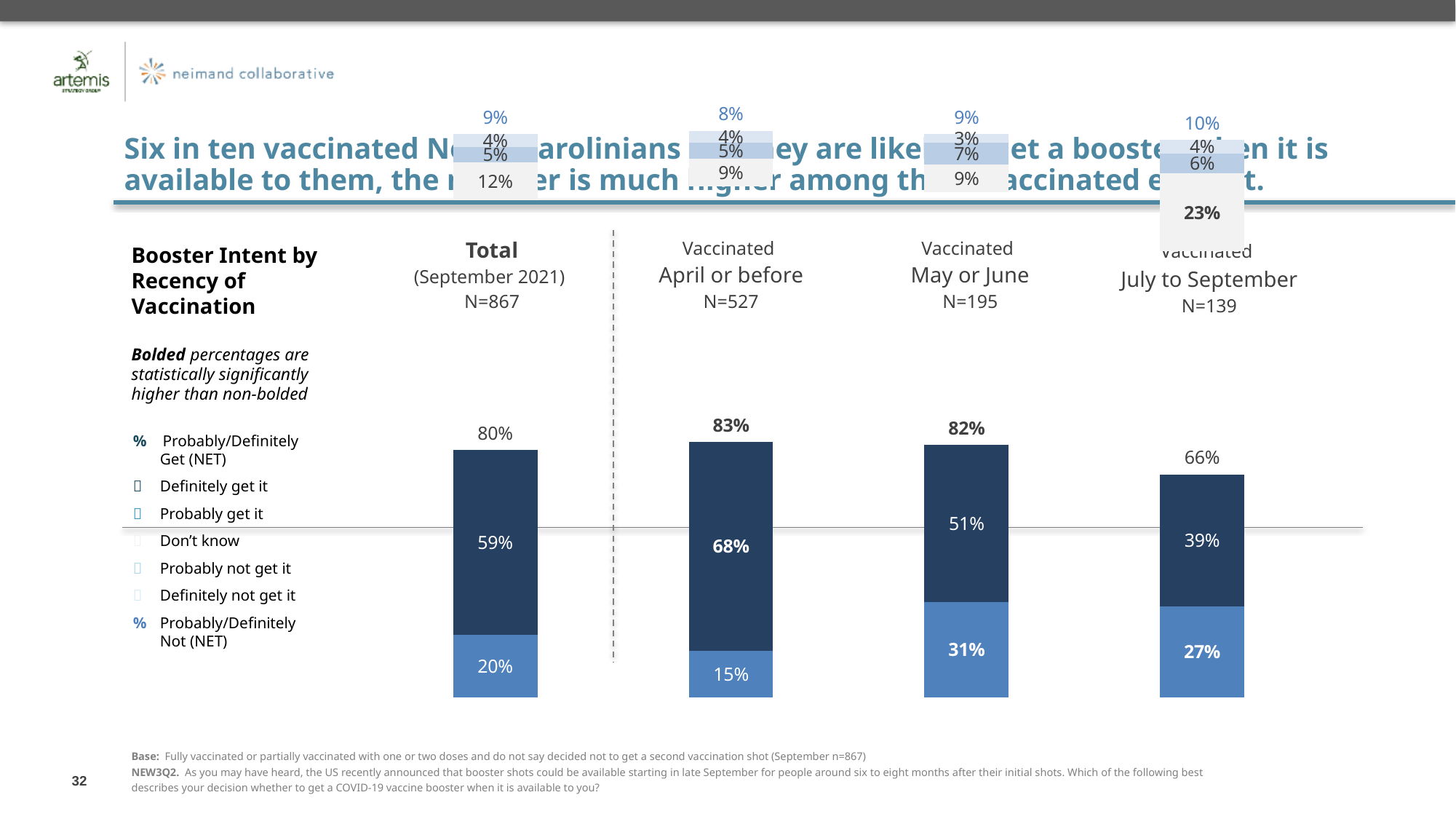
What is the difference between the Definitely get it percentages for Vaccinated April or before and Vaccinated July to September? 29% What percentage of those vaccinated May or June say they will probably get the booster? 31% What is the Probably/Definitely Not (NET) percentage for the Vaccinated July to September group? 10% Which is larger: the Probably get it percentage for Vaccinated May or June or for the Total group? Vaccinated May or June What type of chart is used to show booster intent? Stacked bar chart How many vaccination-recency groups (bars) are shown in the chart? 4 Which group has the highest Probably/Definitely Get (NET) percentage? Vaccinated April or before What is the sample size (N) for the Vaccinated May or June group? N=195 Which group has the lowest Definitely get it percentage? Vaccinated July to September What is the Probably/Definitely Get (NET) percentage for the Total (September 2021) group? 80% What is the Don't know percentage for the Vaccinated July to September group? 23% What percentage of those vaccinated April or before say they will definitely get the booster? 68%